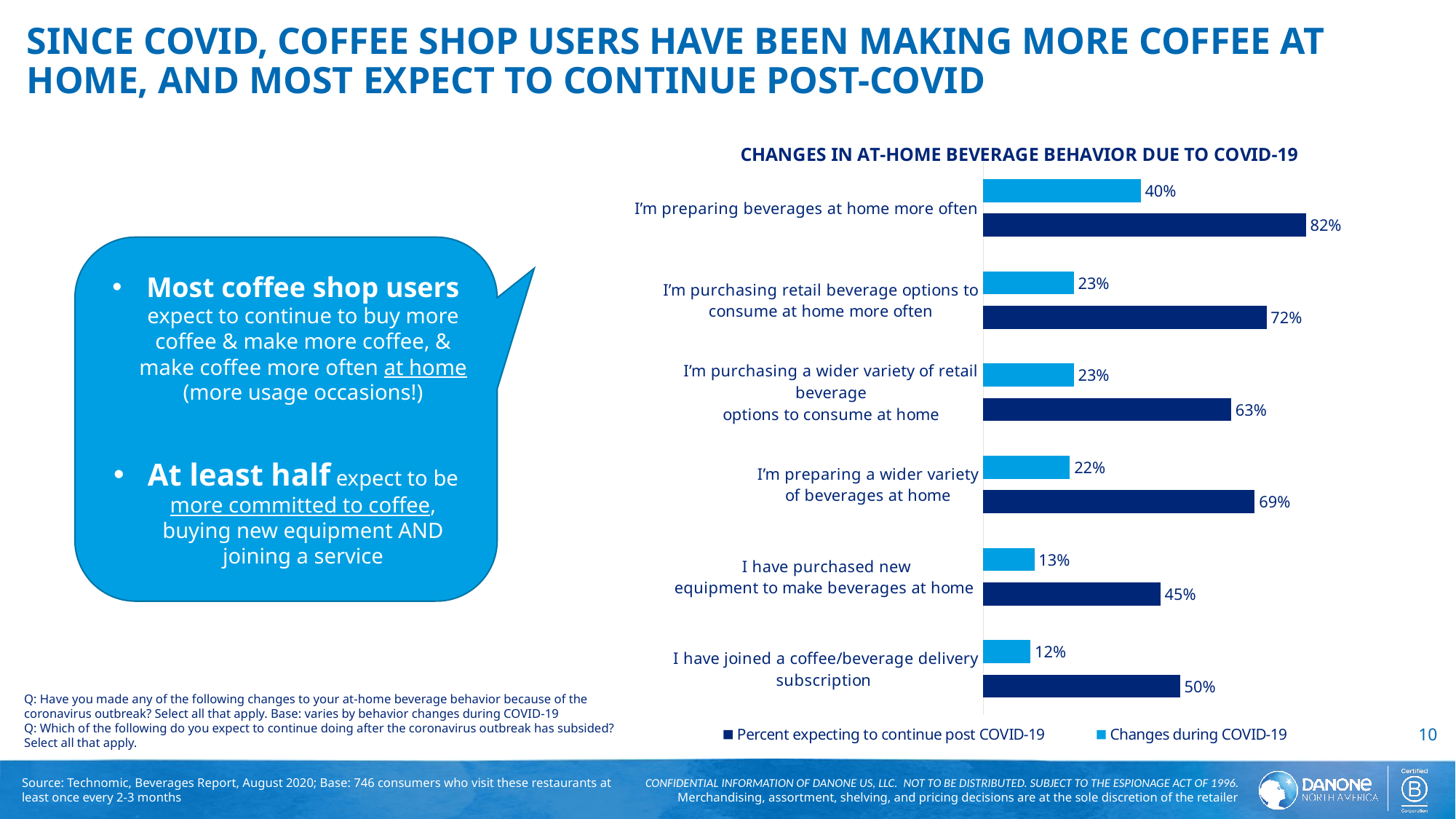
What kind of chart is shown on the slide? Bar chart What is the value of 'Percent expecting to continue post COVID-19' for 'I'm preparing beverages at home more often'? 82% Which is larger for 'I'm preparing a wider variety of beverages at home': the 'Percent expecting to continue post COVID-19' value or the 'Changes during COVID-19' value? Percent expecting to continue post COVID-19 What is the value of 'Percent expecting to continue post COVID-19' for 'I have purchased new equipment to make beverages at home'? 45% How many behavior categories are shown in the chart? 6 Which category has the lowest value for 'Percent expecting to continue post COVID-19'? I have purchased new equipment to make beverages at home Which colour represents the 'Changes during COVID-19' series? Light blue What is the title of the chart? CHANGES IN AT-HOME BEVERAGE BEHAVIOR DUE TO COVID-19 How many series does the chart legend list? 2 What is the difference between the 'Percent expecting to continue post COVID-19' and 'Changes during COVID-19' values for 'I'm purchasing retail beverage options to consume at home more often'? 49% What is the value of 'Changes during COVID-19' for 'I have joined a coffee/beverage delivery subscription'? 12% Which category has the highest value for 'Changes during COVID-19'? I'm preparing beverages at home more often